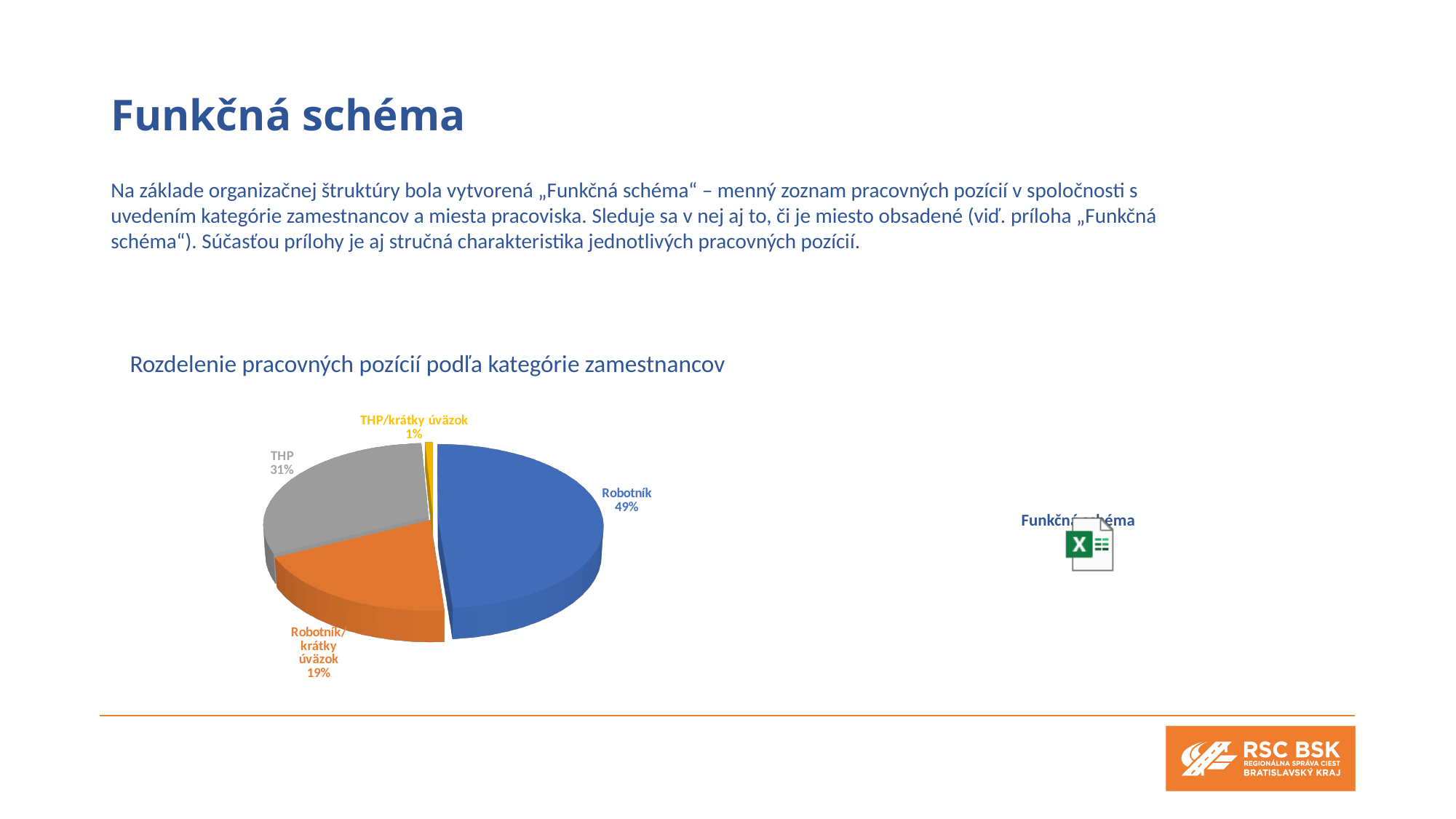
What share of the pie does THP/krátky úväzok have? 1% What share of the pie does THP have? 31% What kind of chart is shown on the slide? pie chart What is the difference in percentage points between Robotník and THP? 18 What is the title of the chart? Rozdelenie pracovných pozícií podľa kategórie zamestnancov What share of the pie does Robotník/krátky úväzok have? 19% Which is larger, the share for THP or the share for Robotník/krátky úväzok? THP Which category has the largest slice of the pie? Robotník Which category has the smallest slice of the pie? THP/krátky úväzok How many categories are shown in the pie chart? 4 What colour is the Robotník slice? blue